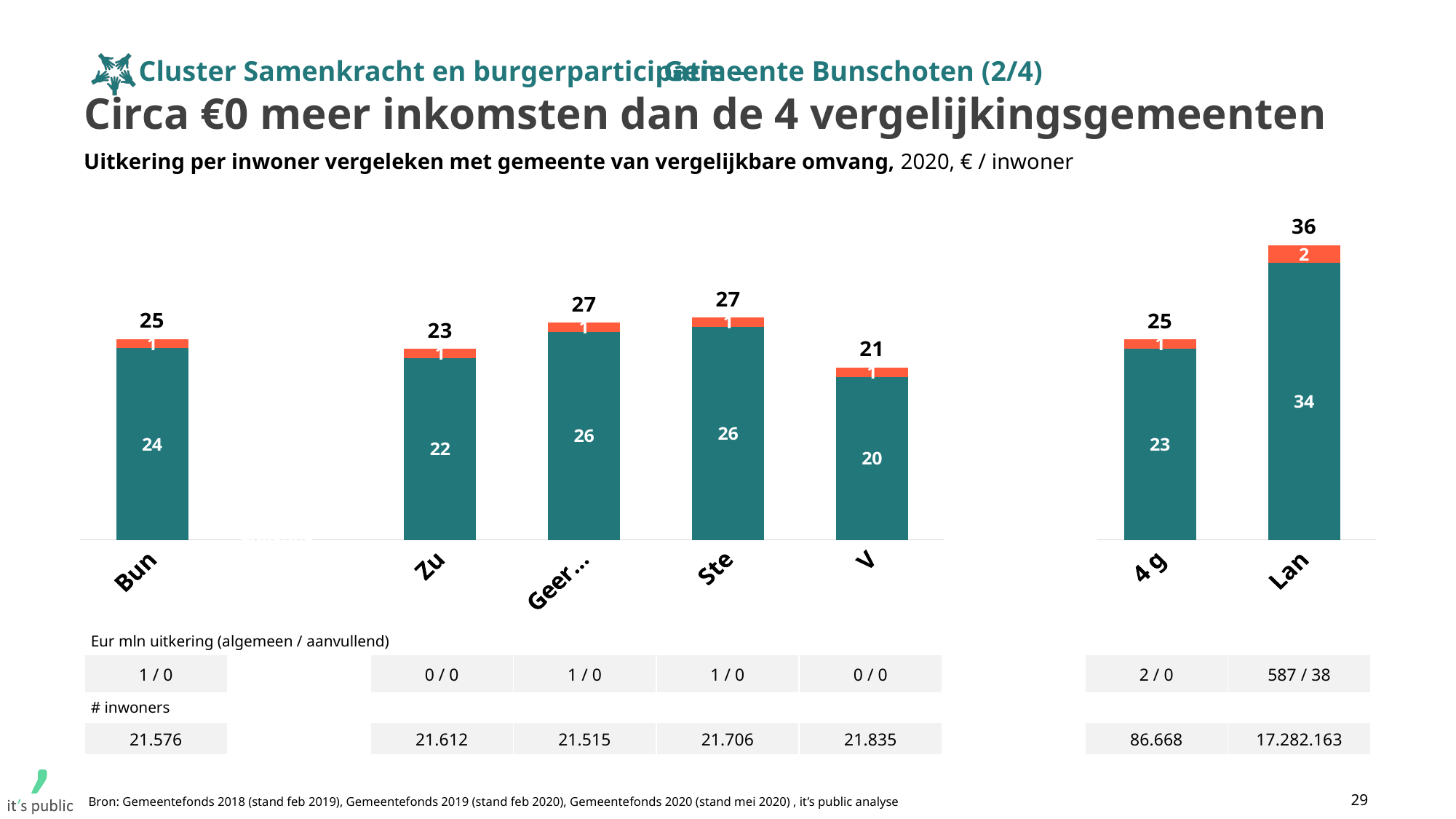
How many bars are plotted in the chart? 7 Which category has the highest total value? Lan What is the total value shown above the bar for Ste? 27 Which has a larger total value, Ste or Zu? Ste Which category has the lowest total value? V What is the difference between the total for Ste and the total for Zu? 4 What is the value of the teal (lower) segment of the bar for Lan? 34 What kind of chart is shown on the slide? Stacked bar chart What year does the chart subtitle say the data is for? 2020 What is the difference between the total for Lan and the total for Bun? 11 What is the value of the orange (upper) segment of the bar for Lan? 2 What is the total value shown above the bar for Bun? 25